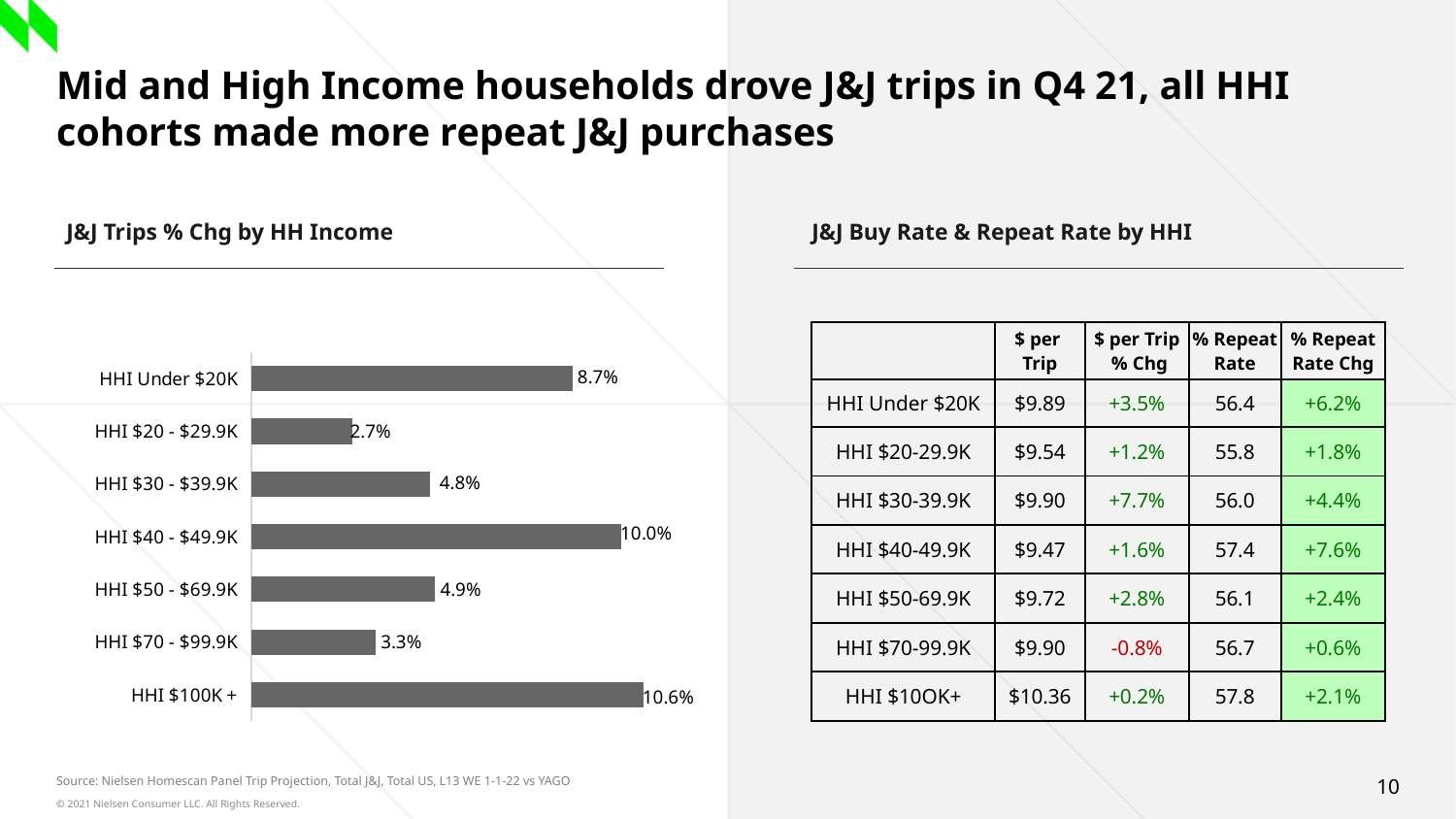
In the 'J&J Trips % Chg by HH Income' chart, what is the value for HHI $100K +? 10.6% In the 'J&J Trips % Chg by HH Income' chart, what is the value for HHI Under $20K? 8.7% In the 'J&J Trips % Chg by HH Income' chart, what is the value for HHI $40 - $49.9K? 10.0% In the 'J&J Trips % Chg by HH Income' chart, which is larger: the value for HHI Under $20K or HHI $30 - $39.9K? HHI Under $20K In the 'J&J Trips % Chg by HH Income' chart, what is the difference between the values for HHI $100K + and HHI $40 - $49.9K? 0.6 percentage points What is the title of the bar chart on the left of the slide? J&J Trips % Chg by HH Income In the 'J&J Trips % Chg by HH Income' chart, what is the difference between the values for HHI Under $20K and HHI $20 - $29.9K? 6.0 percentage points Which income cohort has the highest J&J trips % change in the 'J&J Trips % Chg by HH Income' chart? HHI $100K + Which income cohort has the lowest J&J trips % change in the 'J&J Trips % Chg by HH Income' chart? HHI $20 - $29.9K In the 'J&J Trips % Chg by HH Income' chart, what is the value for HHI $70 - $99.9K? 3.3% What kind of chart is 'J&J Trips % Chg by HH Income'? bar chart How many household income categories are shown in the 'J&J Trips % Chg by HH Income' chart? 7